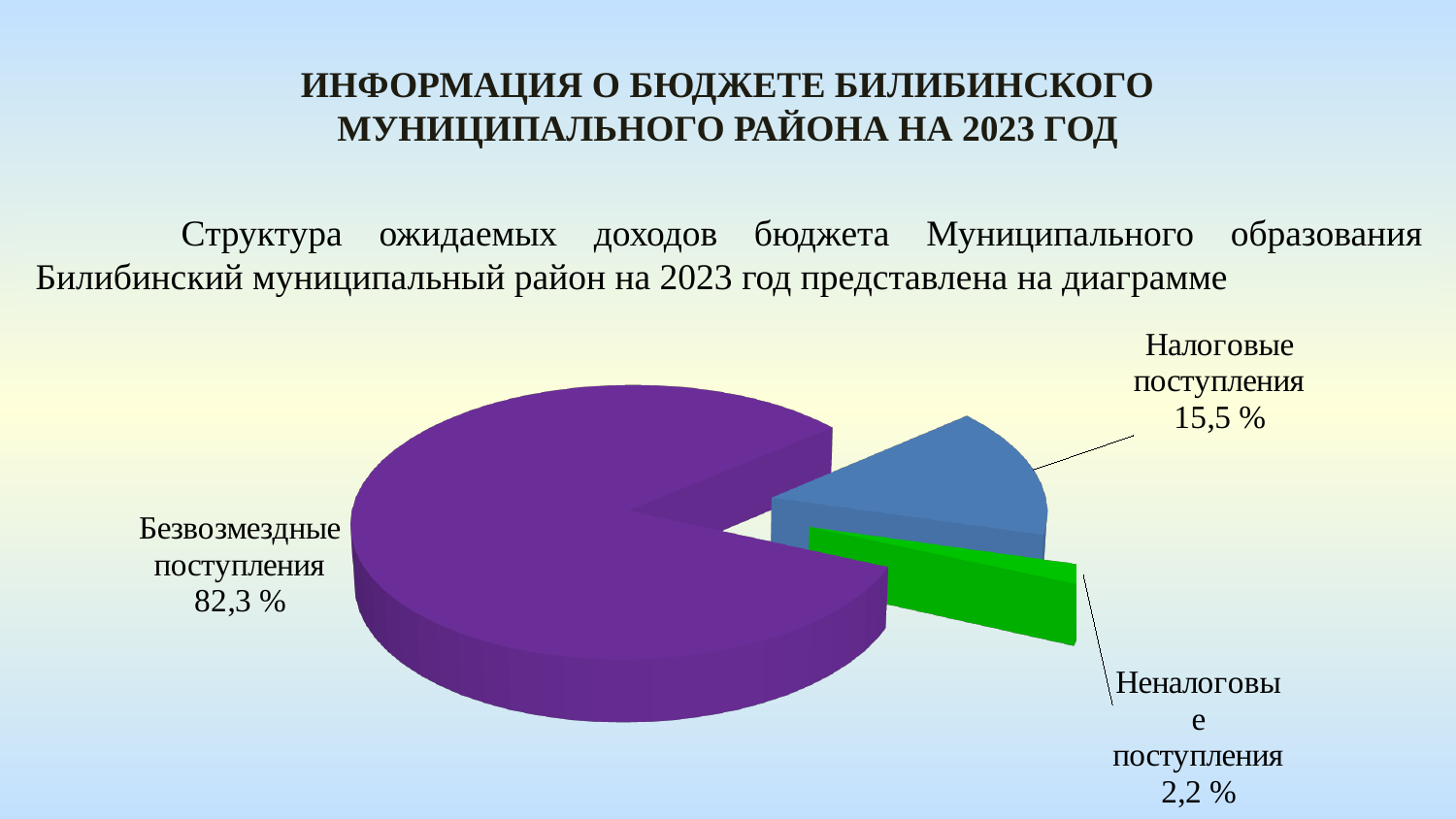
What share of the pie does Безвозмездные поступления have? 82,3 % What is the value shown for Неналоговые поступления? 2,2 % Which category has the largest share of the pie? Безвозмездные поступления What is the difference between the shares of Безвозмездные поступления and Налоговые поступления? 66,8 % What is the difference between the shares of Налоговые поступления and Неналоговые поступления? 13,3 % What kind of chart is shown on the slide? Pie chart What colour is the slice for Безвозмездные поступления? Purple What is the value shown for Налоговые поступления? 15,5 % Which is larger: the share of Налоговые поступления or Неналоговые поступления? Налоговые поступления What colour is the slice for Неналоговые поступления? Green Which category has the smallest share of the pie? Неналоговые поступления How many categories are shown in the pie chart? 3